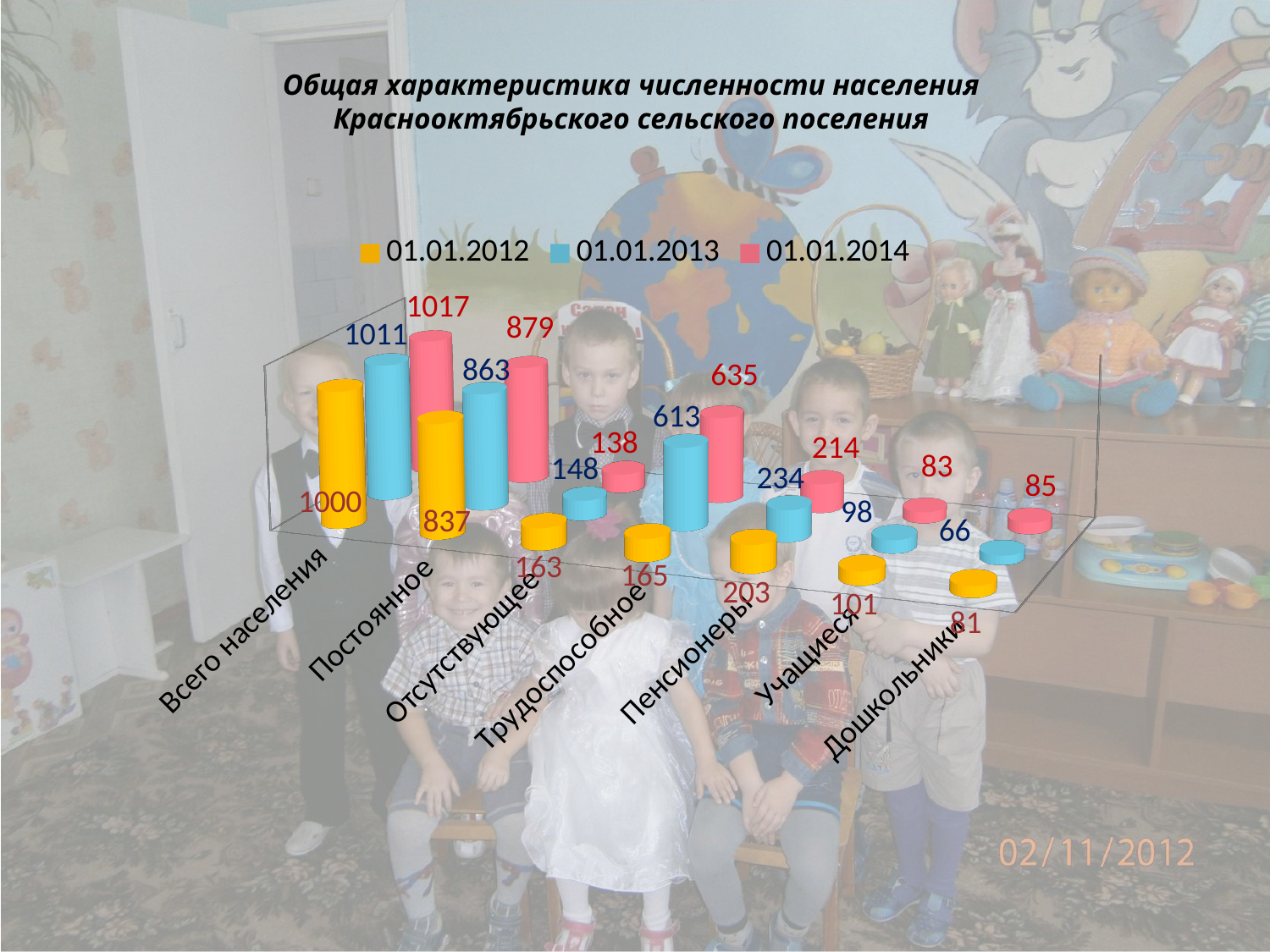
Which category has the highest value for the 01.01.2014 series? Всего населения What is the value for Пенсионеры on 01.01.2012? 203 What kind of chart is shown on the slide? bar chart How many categories are shown along the x axis? 7 Which date does the red series in the legend represent? 01.01.2014 What is the value for Постоянное on 01.01.2013? 863 What is the difference between the Всего населения values for 01.01.2014 and 01.01.2012? 17 What is the value for Всего населения on 01.01.2014? 1017 Which category has the lowest value for the 01.01.2013 series? Дошкольники Do the values for Отсутствующее rise or fall from 01.01.2012 to 01.01.2014? fall How many series does the legend list? 3 For Учащиеся, which is larger: the value for 01.01.2012 or for 01.01.2014? 01.01.2012